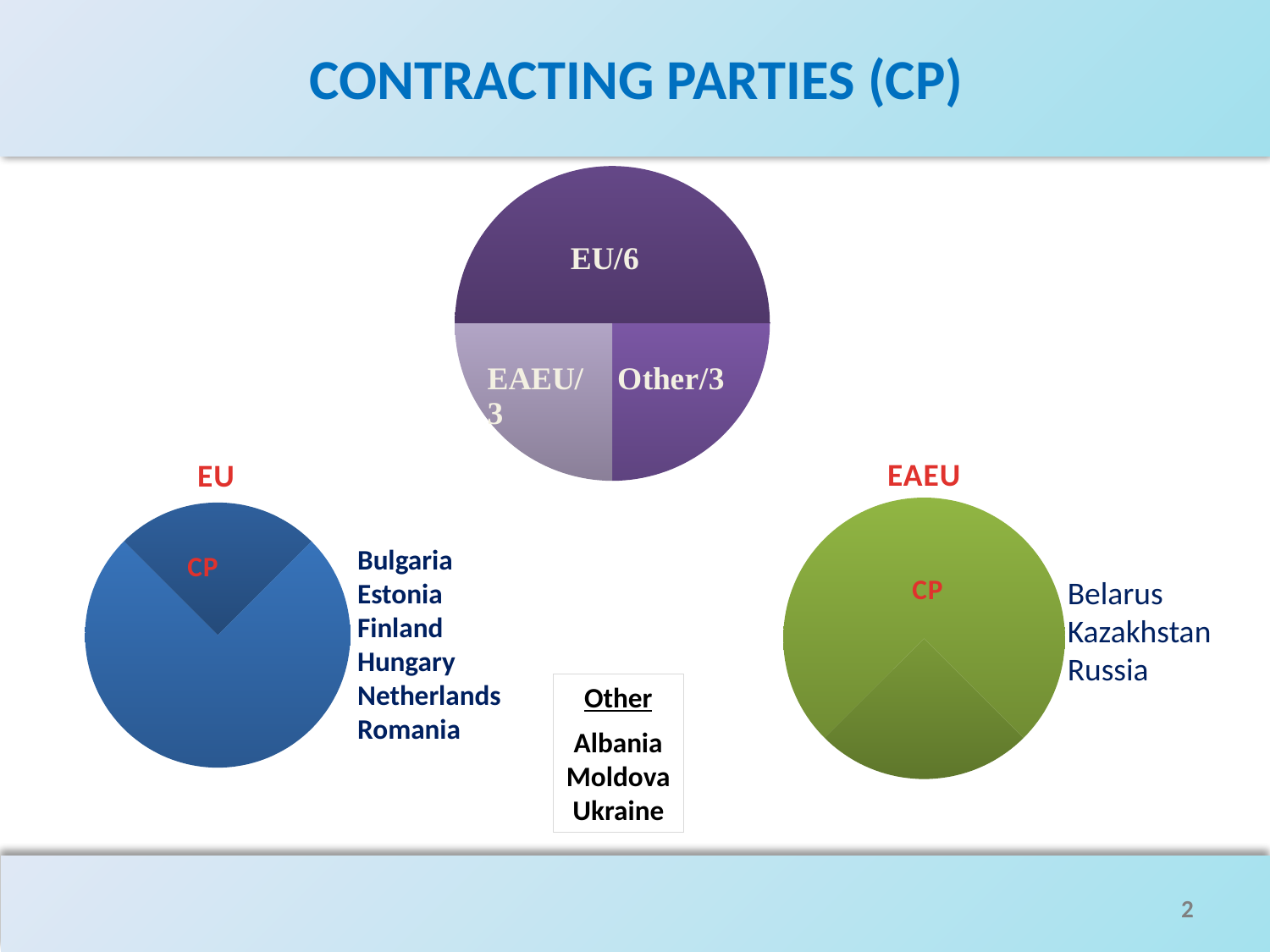
Which slice of the pie chart is the largest? EU What value is shown for the EAEU slice of the pie chart? 3 In the pie chart, which is larger: EU or Other? EU What share of the pie chart does the Other slice represent? 25% What is the total of all slices in the pie chart? 12 What share of the pie chart does the EU slice represent? 50% What value is shown for the EU slice of the pie chart? 6 What kind of chart is shown at the top of the slide? pie chart What value is shown for the Other slice of the pie chart? 3 What is the title of the slide containing the pie chart? CONTRACTING PARTIES (CP) What is the difference between the EU value and the EAEU value in the pie chart? 3 How many slices does the pie chart have? 3